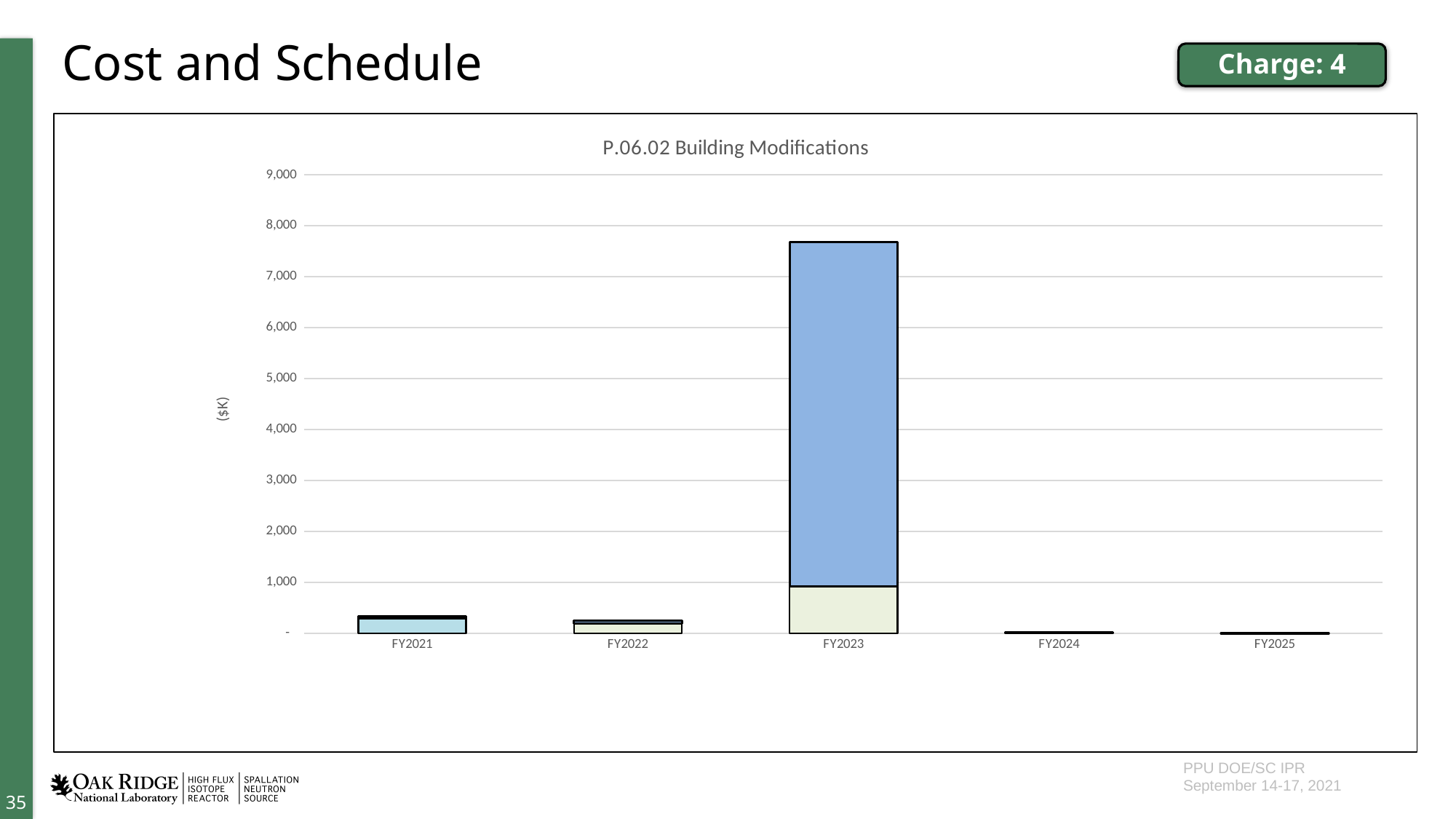
Is the total value for FY2023 greater or less than 7,000? greater Is the total value for FY2023 greater or less than 8,000? less Is the value for FY2021 greater or less than 1,000? less Which is larger, the bar for FY2023 or the bar for FY2021? FY2023 What is the title of the chart? P.06.02 Building Modifications What kind of chart is shown on the slide? bar chart Which is larger, the bar for FY2022 or the bar for FY2025? FY2022 How many fiscal years are shown on the x axis of the chart? 5 What is the label on the y axis of the chart? ($K) Which fiscal year has the highest total bar in the chart? FY2023